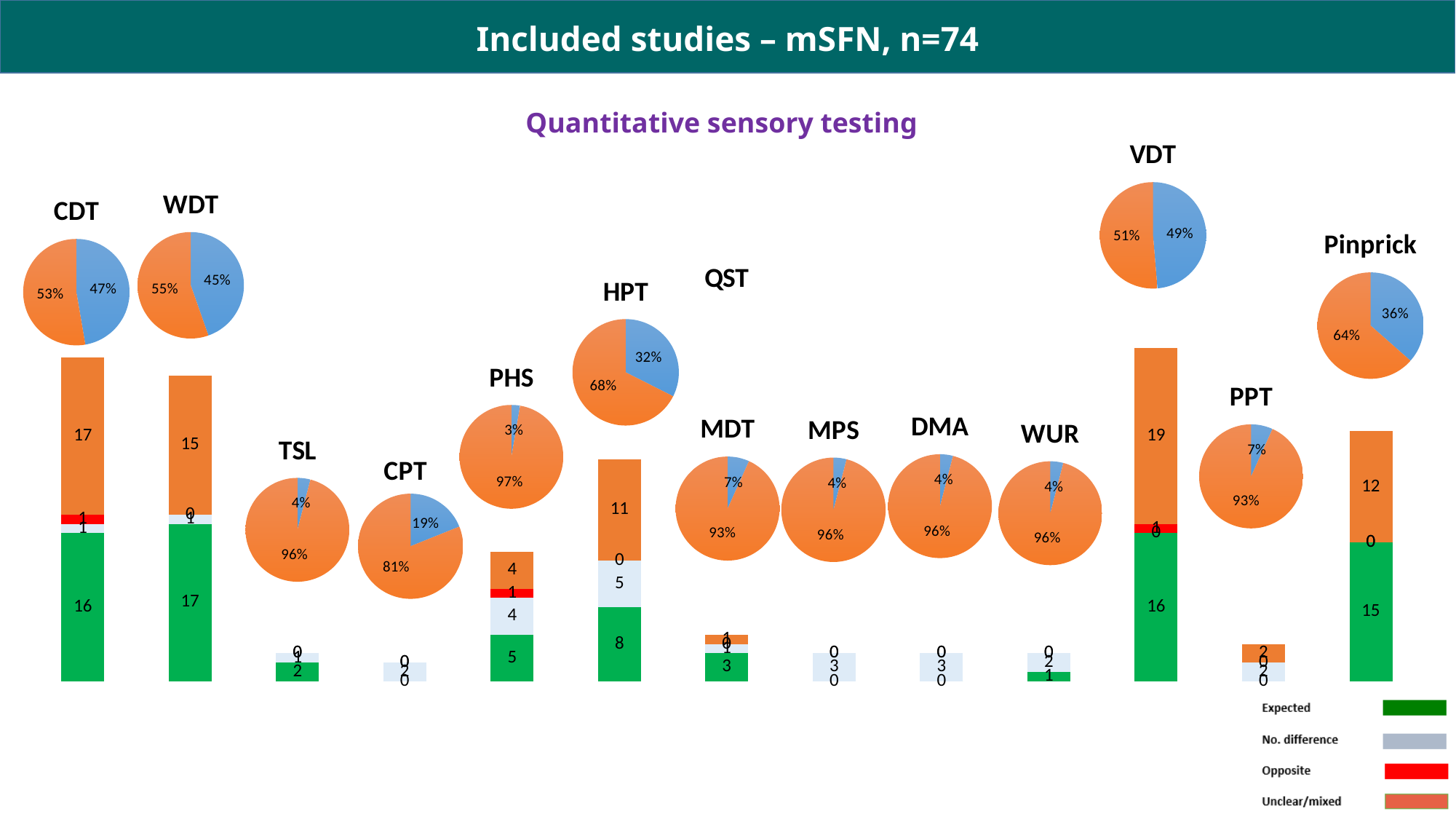
In the HPT stacked bar, what is the value of the green (Expected) segment? 8 In the Pinprick pie chart, what percentage does the orange slice show? 64% What is the total of the HPT stacked bar? 24 Which is larger: the green segment of the WDT bar or the green segment of the CDT bar? WDT How many pie charts are shown on the slide? 13 How many categories does the legend for the stacked bars list? 4 In the CDT pie chart, what percentage does the orange slice show? 53% Across all the pie charts, which one has the smallest blue slice? PHS In the HPT pie chart, what percentage does the blue slice show? 32% Across all the pie charts, which one has the largest blue slice? VDT What is the difference between the orange and blue percentages in the CPT pie chart? 62% In the Pinprick stacked bar, what is the value of the orange (Unclear/mixed) segment? 12